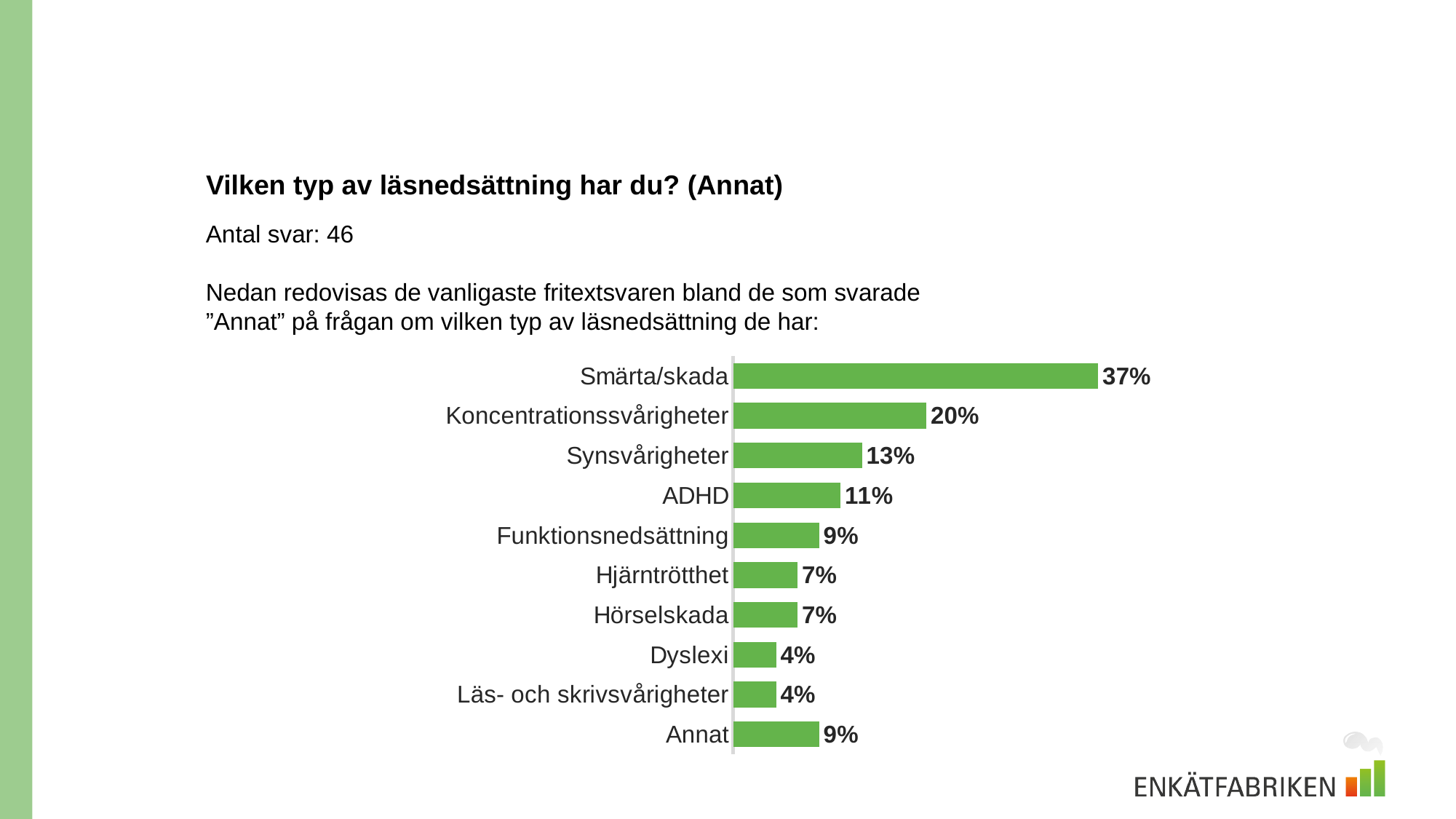
What is the difference between the values for Smärta/skada and Koncentrationssvårigheter? 17% How many categories are shown in the chart? 10 What kind of chart is shown on the slide? Bar chart What is the title of the chart on the slide? Vilken typ av läsnedsättning har du? (Annat) What is the value for ADHD? 11% Which is larger, the value for Funktionsnedsättning or the value for Hjärntrötthet? Funktionsnedsättning What is the value for Smärta/skada? 37% What is the value for Hörselskada? 7% What is the difference between the values for Synsvårigheter and Dyslexi? 9% Which category has the highest value? Smärta/skada What is the value for Koncentrationssvårigheter? 20% Which is larger, the value for Synsvårigheter or the value for Annat? Synsvårigheter